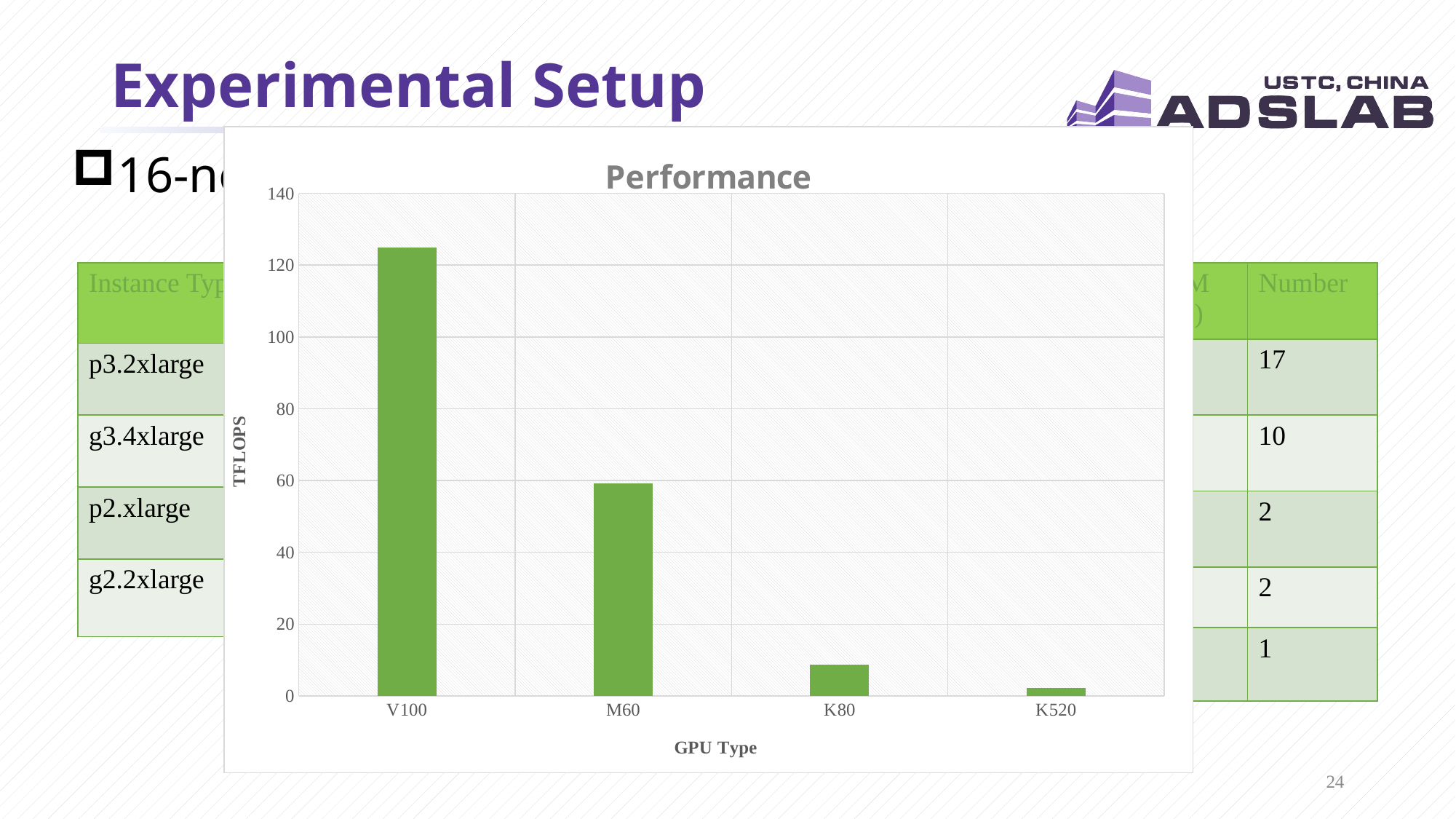
Is the value for V100 greater or less than 120? greater What is the label of the vertical axis of the chart? TFLOPS What type of chart is shown on the slide? bar chart Is the value for M60 greater or less than 80? less Which GPU type has the lowest TFLOPS value in the chart? K520 Which GPU type has the highest TFLOPS value in the chart? V100 Which has a higher TFLOPS value, K80 or K520? K80 How many GPU types are plotted in the chart? 4 Is the value for K80 greater or less than 20? less What is the title of the chart? Performance Do the TFLOPS values rise or fall moving from V100 to K520 along the x axis? fall